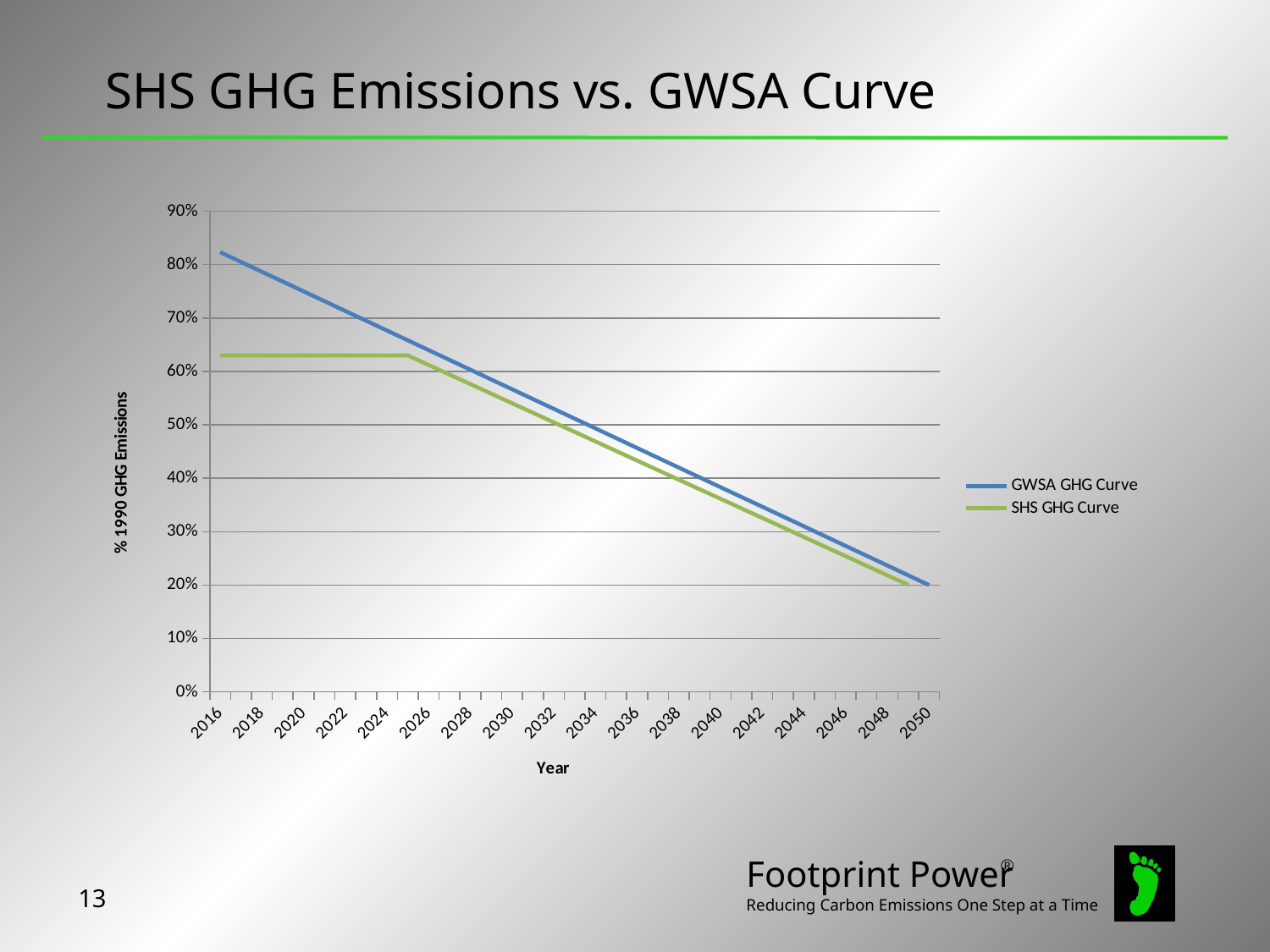
Is the value of the GWSA GHG Curve in 2016 greater or less than 80%? greater Which series starts at the higher value in 2016? GWSA GHG Curve What are the two series named in the legend? GWSA GHG Curve and SHS GHG Curve In 2020, which series has the higher value, GWSA GHG Curve or SHS GHG Curve? GWSA GHG Curve Is the value of the SHS GHG Curve in 2016 greater or less than 60%? greater Does the GWSA GHG Curve rise or fall from 2016 to 2050? Fall Does the SHS GHG Curve rise, fall or stay flat between 2016 and 2024? Stay flat Is the value of the SHS GHG Curve in 2030 greater or less than 50%? greater What is the title of the x axis? Year What kind of chart is shown on the slide? Line chart How many series does the legend list? 2